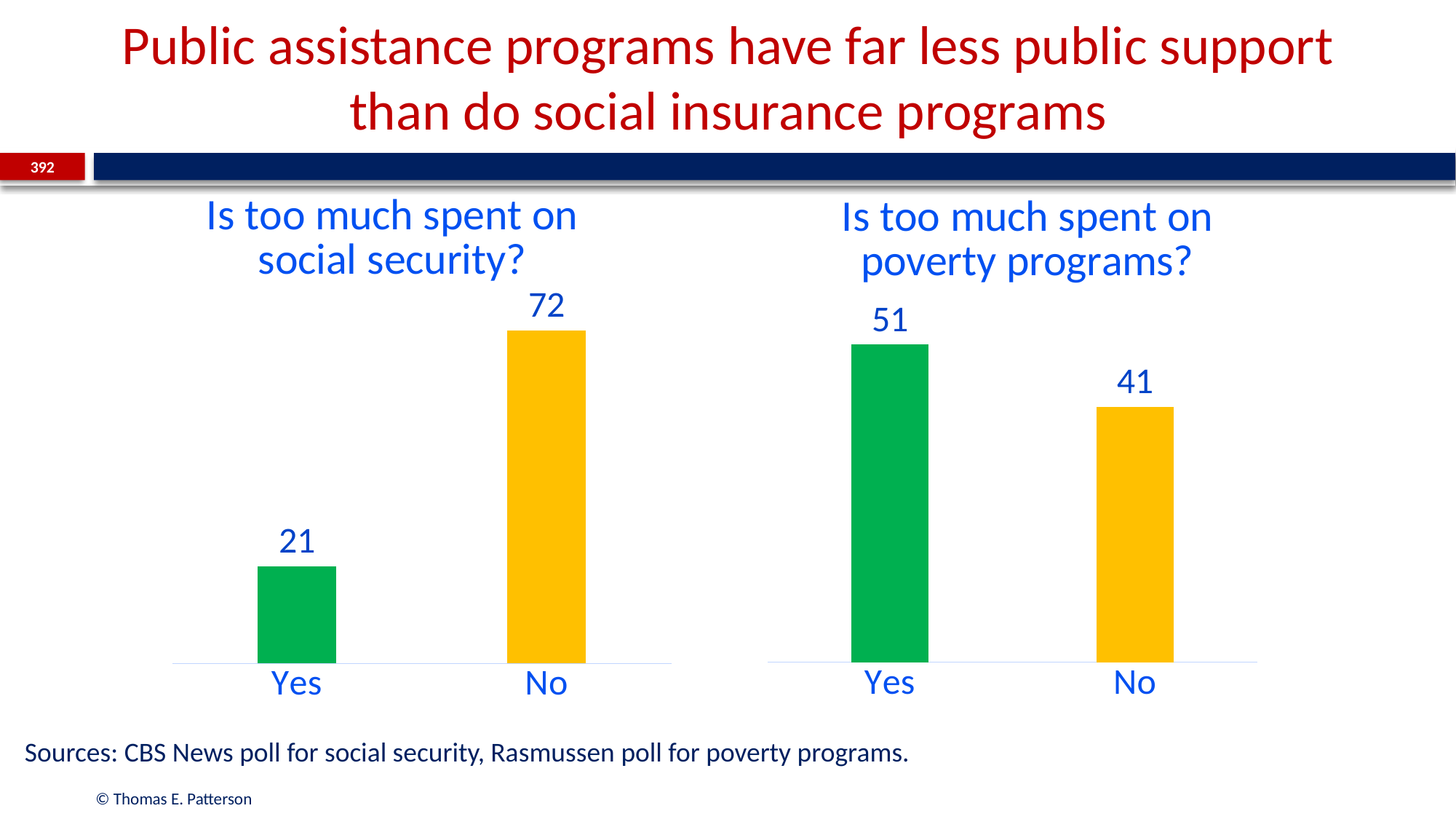
In the chart titled "Is too much spent on poverty programs?", what is the value for Yes? 51 In the chart titled "Is too much spent on poverty programs?", what is the difference between the Yes and No values? 10 In the chart titled "Is too much spent on social security?", what is the difference between the No and Yes values? 51 In the chart titled "Is too much spent on poverty programs?", what is the value for No? 41 What kind of chart is the chart titled "Is too much spent on poverty programs?"? Bar chart In the chart titled "Is too much spent on social security?", what is the value for Yes? 21 In the chart titled "Is too much spent on poverty programs?", which is larger, Yes or No? Yes In the chart titled "Is too much spent on social security?", which category has the highest value? No In the chart titled "Is too much spent on poverty programs?", which category has the lowest value? No How many categories does the chart titled "Is too much spent on social security?" show? 2 In the chart titled "Is too much spent on social security?", what is the value for No? 72 In the chart titled "Is too much spent on social security?", what colour is the Yes bar? Green